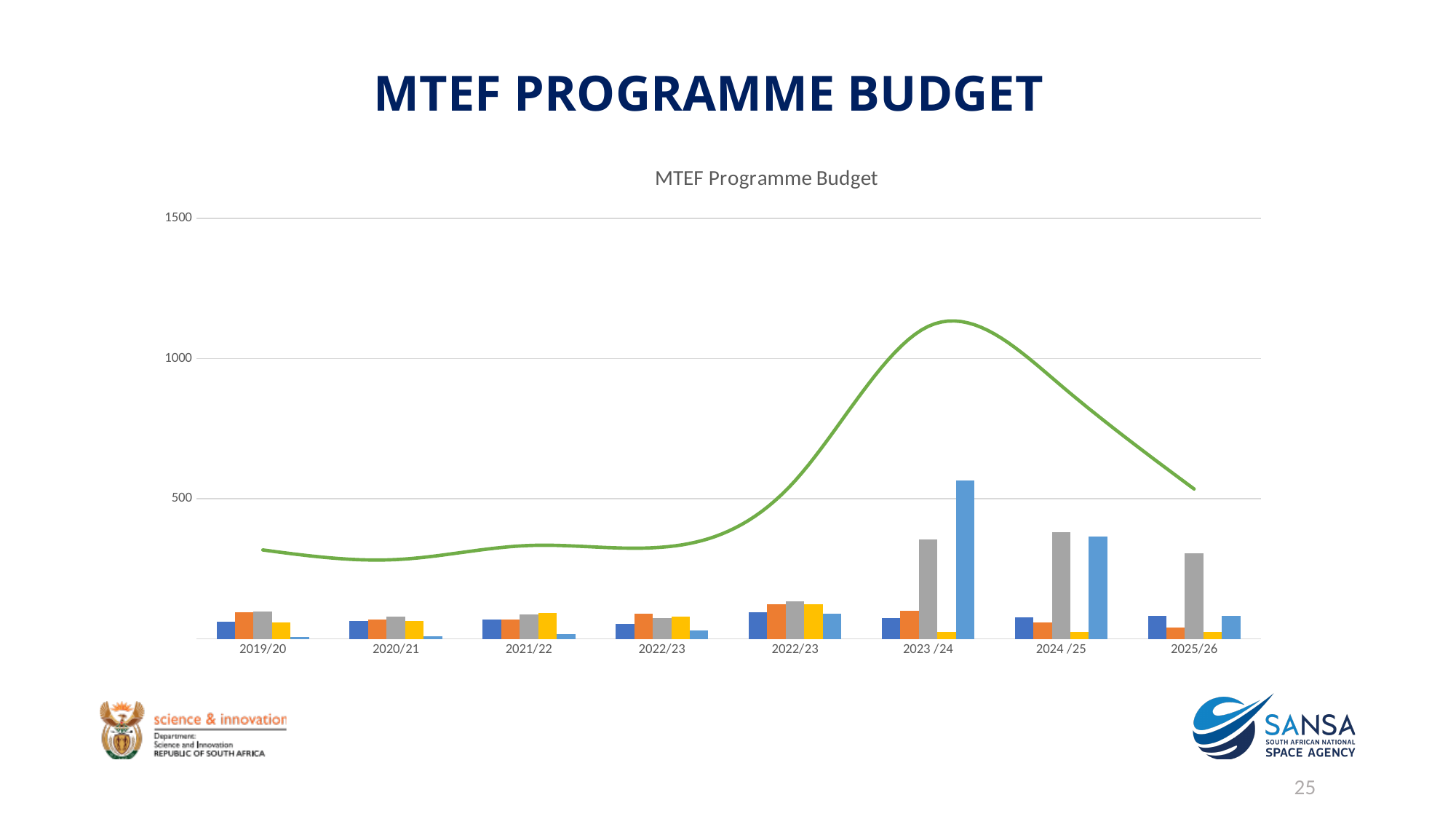
Does the green line rise or fall from 2023 /24 to 2025/26? fall Is the tallest bar at 2023 /24 greater or less than 500? greater What kind of chart is shown on the slide? Combined bar and line chart What is the title of the chart? MTEF Programme Budget In which category does the green line reach its highest point? 2023 /24 Does the green line rise or fall from 2022/23 to 2023 /24? rise Which category contains the tallest bar on the chart? 2023 /24 How many bars are plotted for each category? 5 Is the value of the green line at 2023 /24 greater or less than 1000? greater Is the light blue bar larger at 2023 /24 or at 2024 /25? 2023 /24 Is the value of the green line at 2019/20 greater or less than 500? less How many categories are shown along the x axis? 8